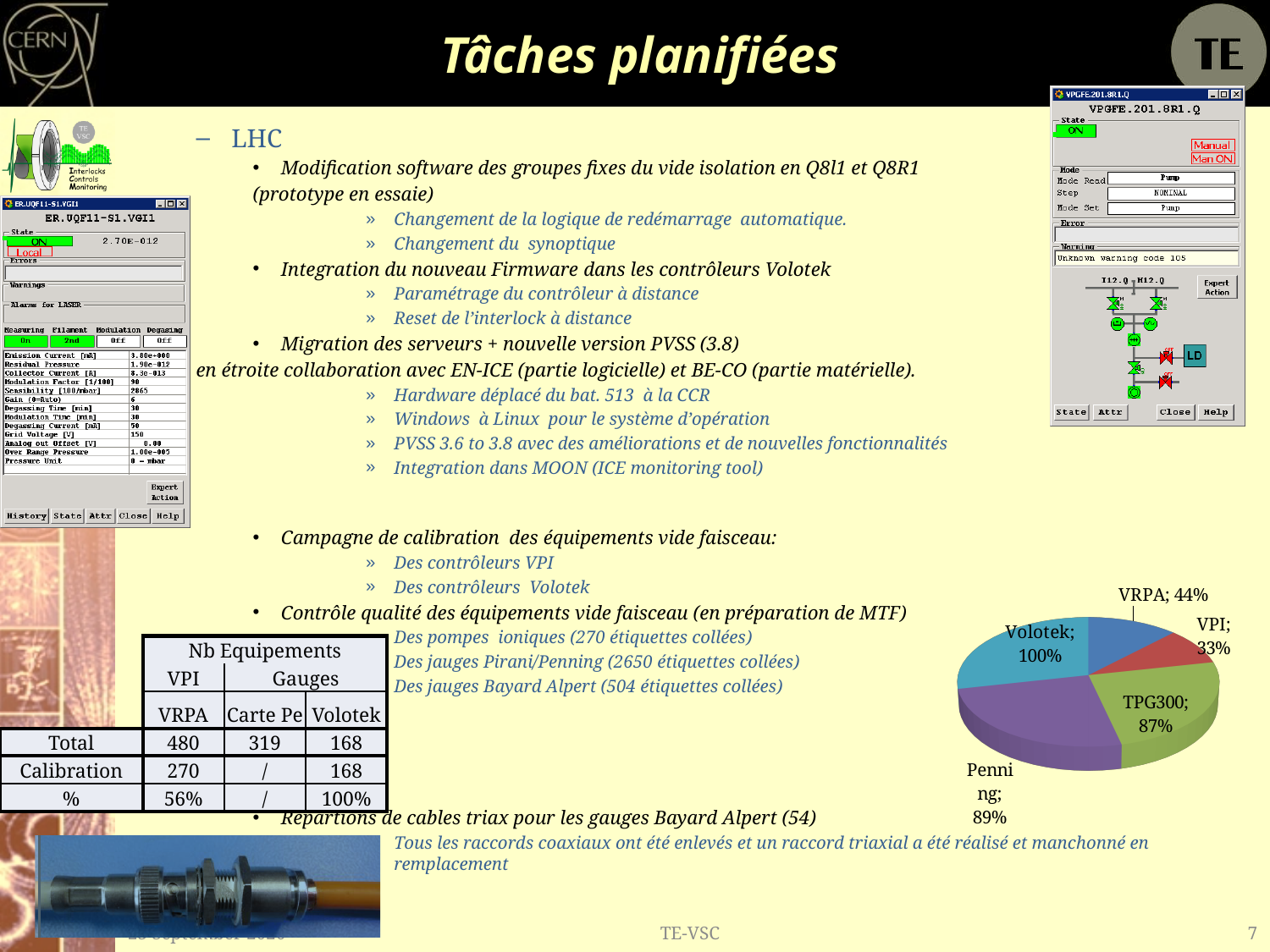
What value is shown for VRPA in the pie chart? 44% Which category has the lowest value in the pie chart? VPI What value is shown for TPG300 in the pie chart? 87% How many slices does the pie chart have? 5 What is the difference between the values for Penning and VPI in the pie chart? 56% What value is shown for VPI in the pie chart? 33% What value is shown for Penning in the pie chart? 89% In the pie chart, which is larger, the value for TPG300 or the value for VRPA? TPG300 Which category has the highest value in the pie chart? Volotek What type of chart is shown on the slide? pie chart What is the difference between the values for Volotek and VRPA in the pie chart? 56% What value is shown for Volotek in the pie chart? 100%